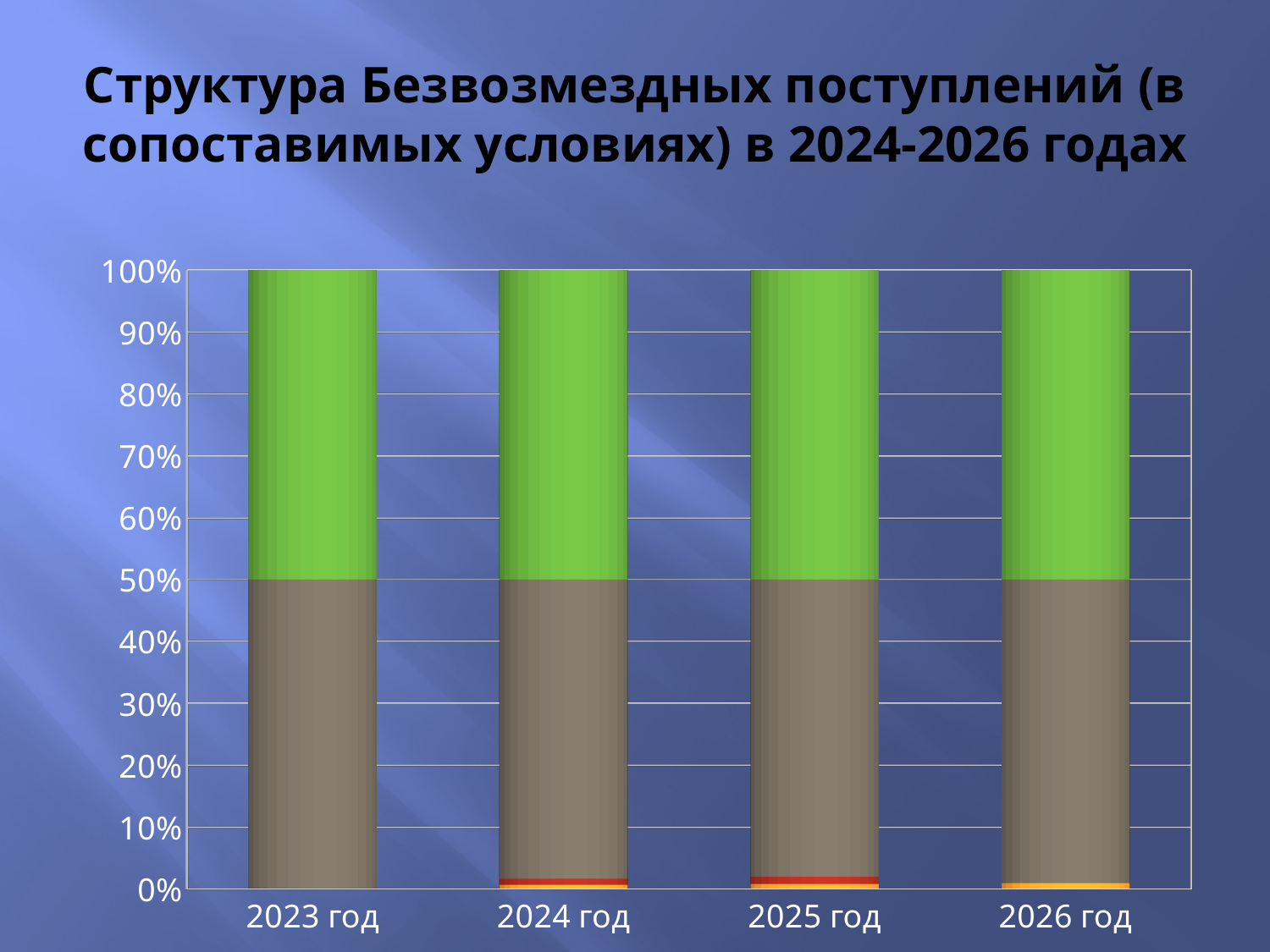
What is the total height of the stacked bar for 2023 год? 100% What kind of chart is shown on the slide? Stacked bar chart Which category is the first one on the x axis? 2023 год What is the total height of the stacked bar for 2026 год? 100% Is the brown segment of the bar for 2025 год greater or less than 60%? less Is the green segment of the bar for 2023 год greater or less than 40%? greater What is the highest value shown on the y axis of the chart? 100% How many year categories are shown on the x axis of the chart? 4 What is the title of the chart on the slide? Структура Безвозмездных поступлений (в сопоставимых условиях) в 2024-2026 годах Is the green segment of the bar for 2026 год greater or less than 30%? greater What colour is the top segment of each stacked bar? Green